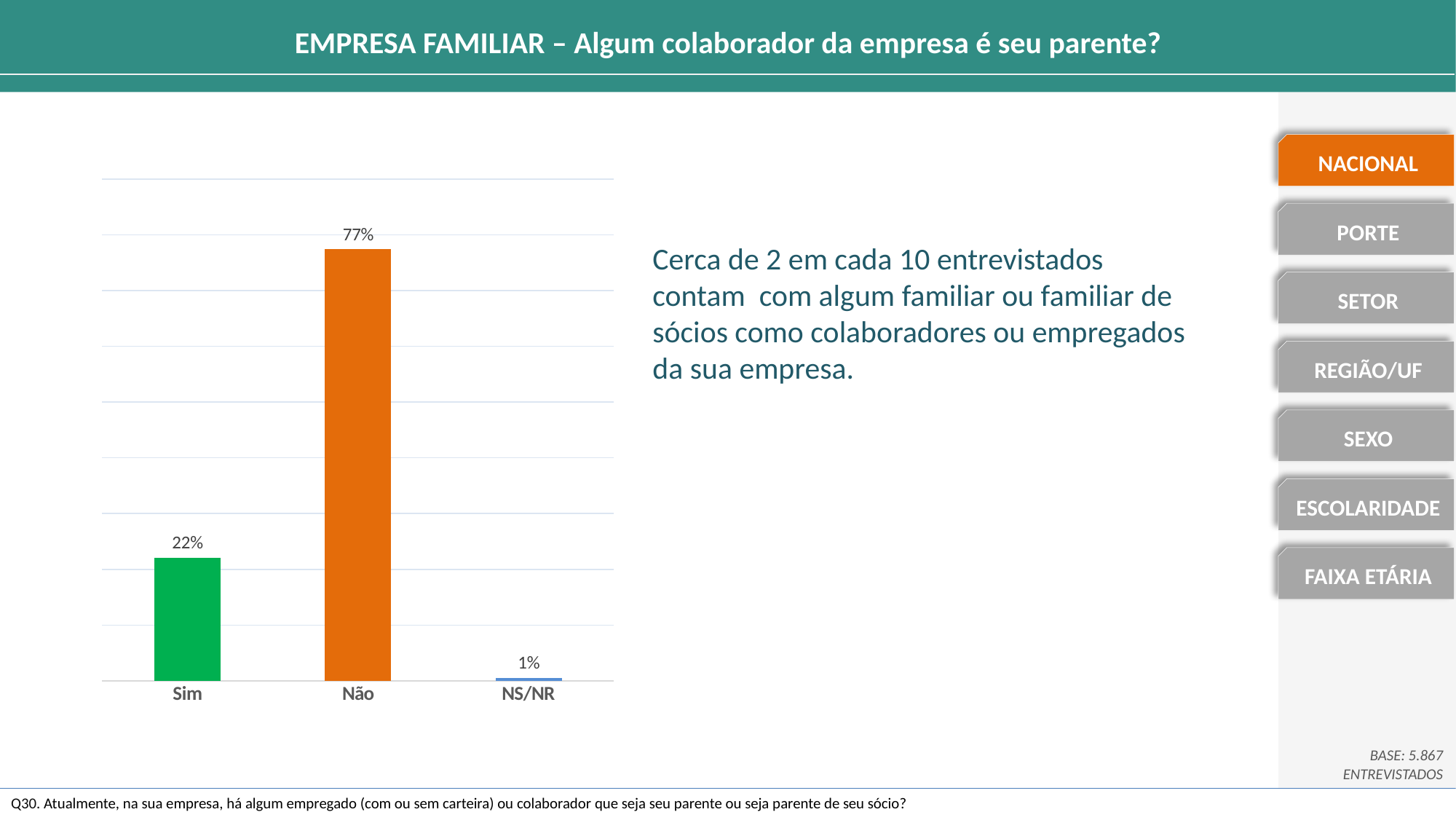
How many categories are shown on the x axis? 3 What is the difference between the values for Não and Sim? 55% What is the difference between the values for Sim and NS/NR? 21% What colour is the bar for Não? Orange What is the value for Não? 77% Which is larger, the value for Sim or the value for NS/NR? Sim Which category has the highest value? Não Which category has the lowest value? NS/NR What kind of chart is shown on the slide? Bar chart What colour is the bar for Sim? Green What is the value for Sim? 22% What is the value for NS/NR? 1%